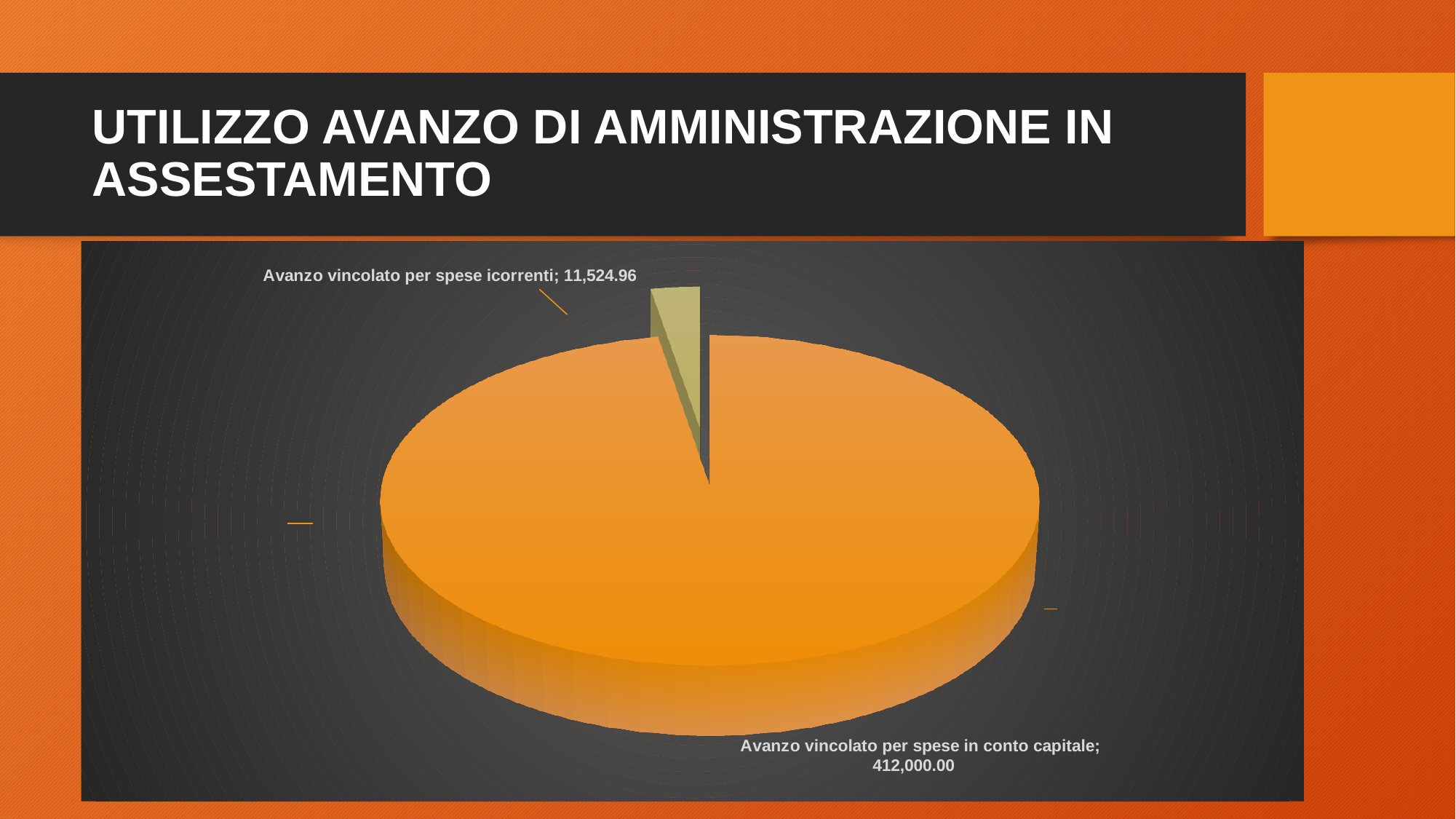
What is the total of the two labelled values in the pie chart? 423,524.96 What is the difference between the value for spese in conto capitale and the value for spese icorrenti? 400,475.04 What is the value for 'Avanzo vincolato per spese in conto capitale'? 412,000.00 Which is larger: the value for spese icorrenti or the value for spese in conto capitale? Spese in conto capitale What is the title of the slide containing the chart? UTILIZZO AVANZO DI AMMINISTRAZIONE IN ASSESTAMENTO Which category has the largest slice of the pie? Avanzo vincolato per spese in conto capitale What colour is the slice for 'Avanzo vincolato per spese in conto capitale'? Orange What kind of chart is shown on the slide? Pie chart What is the value for 'Avanzo vincolato per spese icorrenti'? 11,524.96 Which category has the smallest slice of the pie? Avanzo vincolato per spese icorrenti